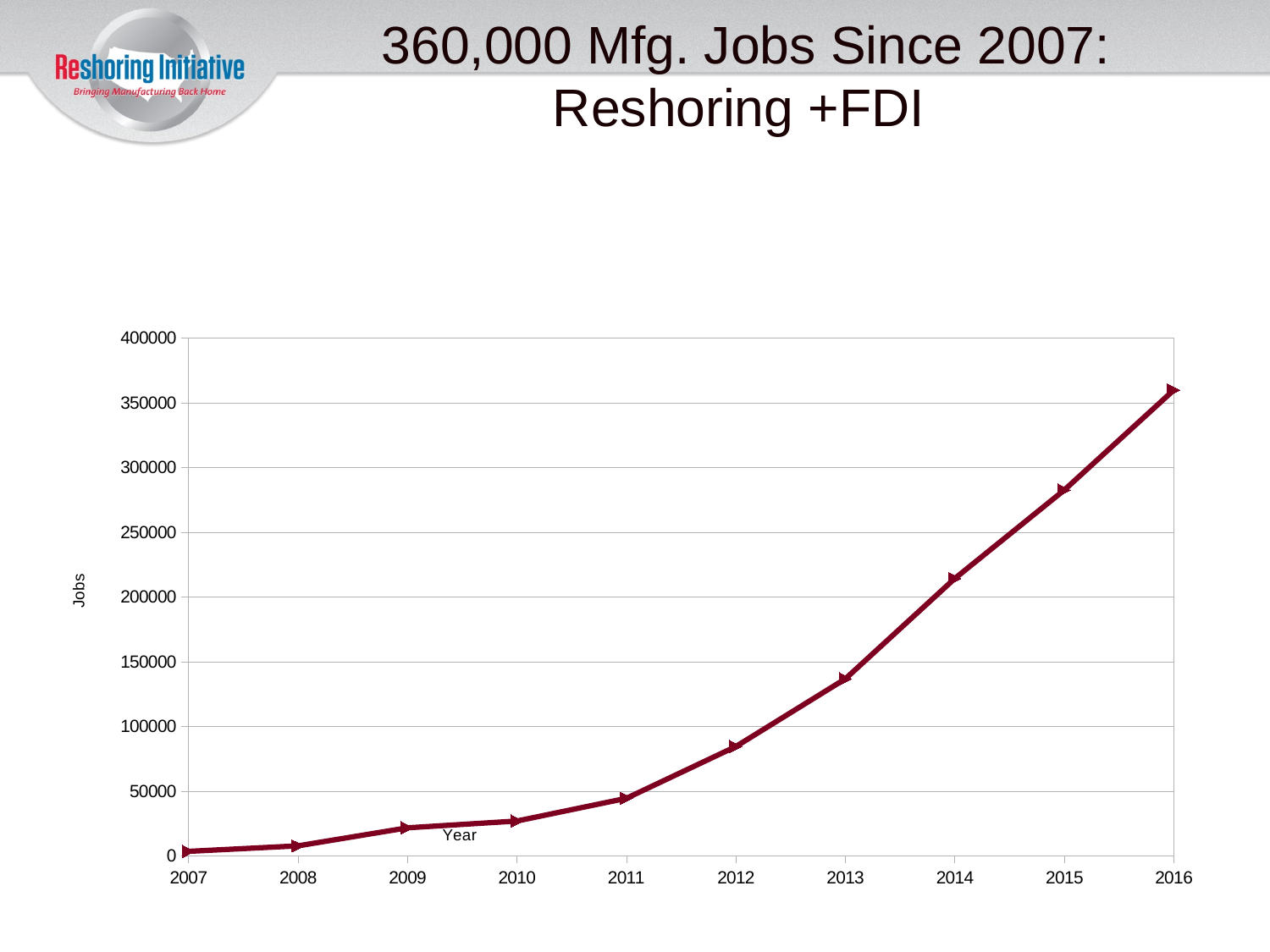
What is the title of the slide containing the chart? 360,000 Mfg. Jobs Since 2007: Reshoring +FDI How many years are plotted along the x axis of the chart? 10 Which year has the lowest number of jobs in the chart? 2007 Is the value for 2013 greater or less than 100000? greater Which year has a larger value, 2014 or 2012? 2014 What kind of chart is shown on the slide? line chart What is the label on the vertical axis of the chart? Jobs Is the value for 2015 greater or less than 300000? less Which year has the highest number of jobs in the chart? 2016 Is the value for 2016 greater or less than 300000? greater Do the values in the chart rise or fall from 2007 to 2016? rise